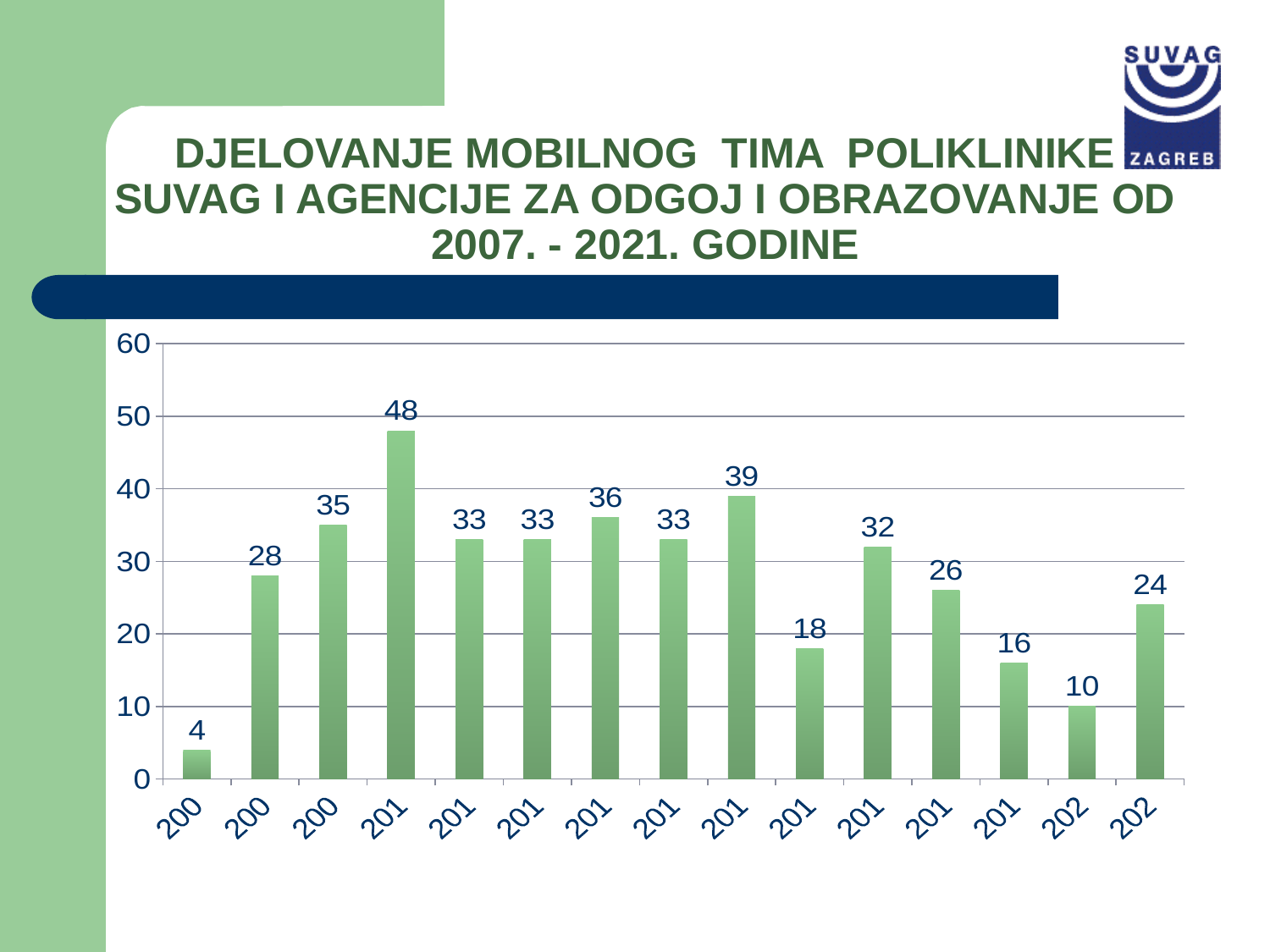
How many bars are plotted in the chart? 15 Is the value of the fourth bar from the left greater or less than 40? greater What type of chart is shown on the slide? bar chart What is the difference between the tallest bar (48) and the shortest bar (4)? 44 What is the value of the second bar from the left? 28 Which is larger: the value of the third bar from the left or the value of the eleventh bar from the left? the third bar (35) What is the value of the tallest bar in the chart? 48 What is the value of the ninth bar from the left? 39 What is the value of the first bar (leftmost) in the chart? 4 What is the value of the shortest bar in the chart? 4 What is the value of the last bar (rightmost) in the chart? 24 What is the highest value shown on the vertical axis? 60